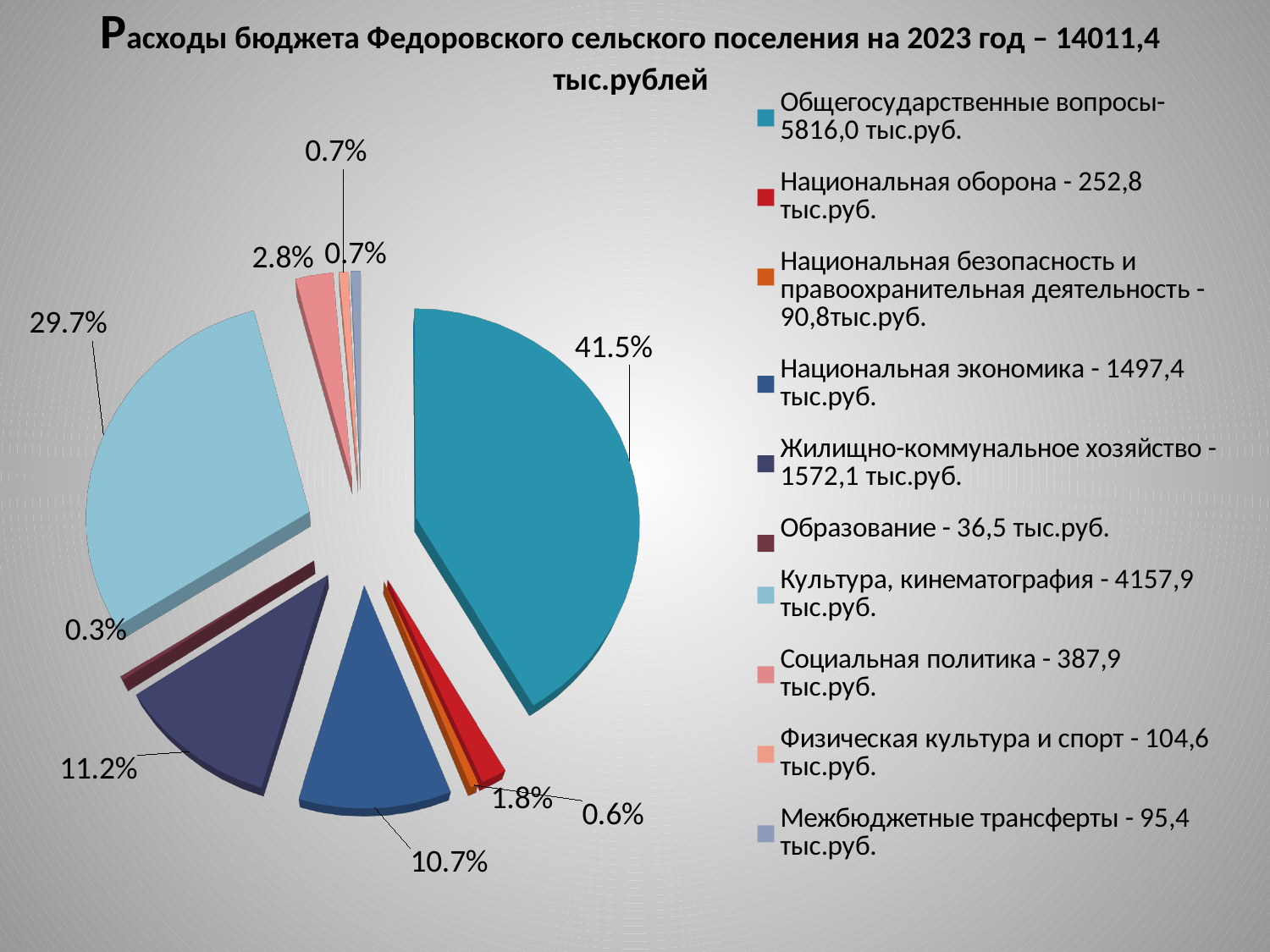
What share of the pie does Жилищно-коммунальное хозяйство take? 11.2% According to the legend, what is the amount for Национальная оборона? 252,8 тыс.руб. How many categories does the legend list? 10 What total budget expenditure is stated in the chart title? 14011,4 тыс.рублей Which category has the largest share of the pie? Общегосударственные вопросы What share of the pie does Национальная экономика take? 10.7% What share of the pie does Культура, кинематография take? 29.7% What kind of chart is shown on the slide? pie chart According to the legend, what is the amount for Социальная политика? 387,9 тыс.руб. Which is larger: the share for Жилищно-коммунальное хозяйство or for Национальная экономика? Жилищно-коммунальное хозяйство Which category has the smallest share of the pie? Образование